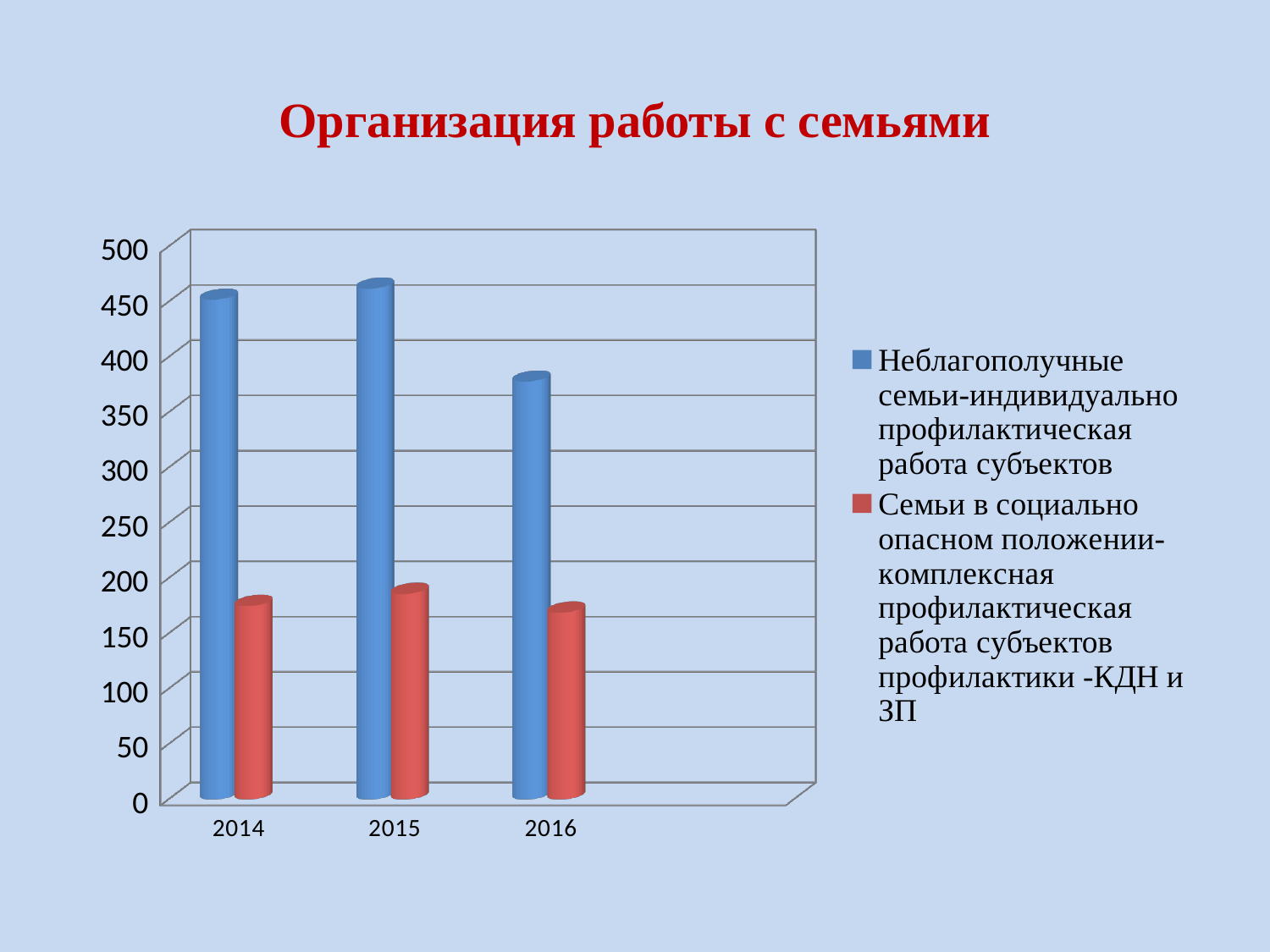
Does the value for 'Неблагополучные семьи-индивидуально профилактическая работа субъектов' rise or fall from 2015 to 2016? fall Which year has the highest value for the series 'Семьи в социально опасном положении-комплексная профилактическая работа субъектов профилактики -КДН и ЗП'? 2015 Is the value for 'Семьи в социально опасном положении-комплексная профилактическая работа субъектов профилактики -КДН и ЗП' in 2015 greater or less than 150? greater Is the value for 'Неблагополучные семьи-индивидуально профилактическая работа субъектов' in 2016 greater or less than 350? greater In 2016, which series has the larger value: 'Неблагополучные семьи-индивидуально профилактическая работа субъектов' or 'Семьи в социально опасном положении-комплексная профилактическая работа субъектов профилактики -КДН и ЗП'? Неблагополучные семьи-индивидуально профилактическая работа субъектов Is the value for 'Неблагополучные семьи-индивидуально профилактическая работа субъектов' in 2014 greater or less than 400? greater What kind of chart is shown on the slide? bar chart How many series does the chart legend list? 2 What colour are the bars for the series 'Семьи в социально опасном положении-комплексная профилактическая работа субъектов профилактики -КДН и ЗП'? red How many years are shown on the x axis of the chart? 3 Which year has the lowest value for the series 'Неблагополучные семьи-индивидуально профилактическая работа субъектов'? 2016